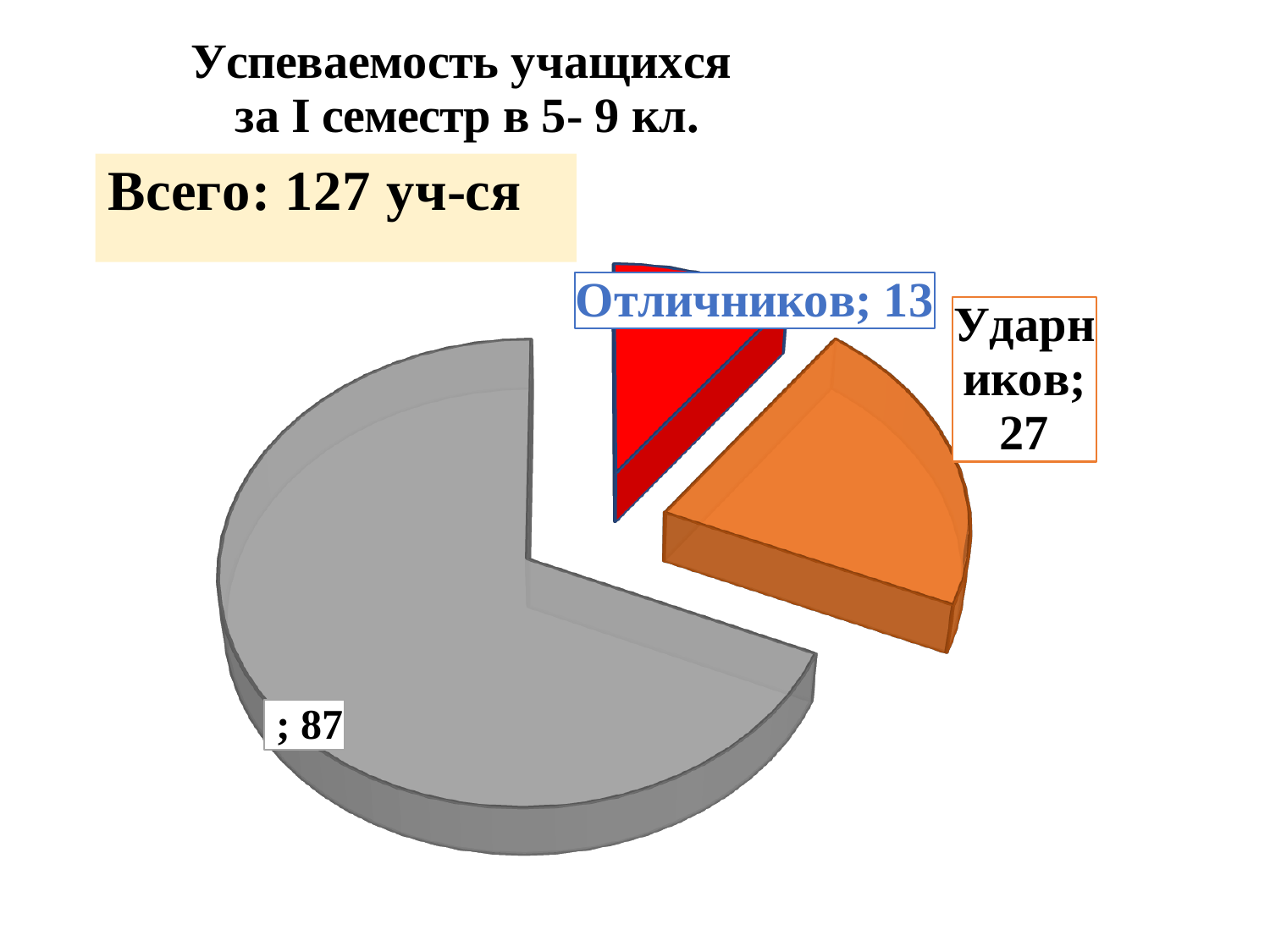
What colour is the slice for Отличников? Red What is the value shown for Отличников on the pie chart? 13 What total number of students is stated on the slide? 127 уч-ся Which is larger, the value for Отличников or the value for Ударников? Ударников Which labelled category has the smallest slice in the pie chart? Отличников What is the total of all the slice values in the pie chart? 127 What is the value shown for Ударников on the pie chart? 27 What is the value of the largest slice in the pie chart? 87 What kind of chart is shown on the slide? Pie chart What value is printed on the large grey slice of the pie chart? 87 By how much does the value for Ударников exceed the value for Отличников? 14 How many slices does the pie chart have? 3